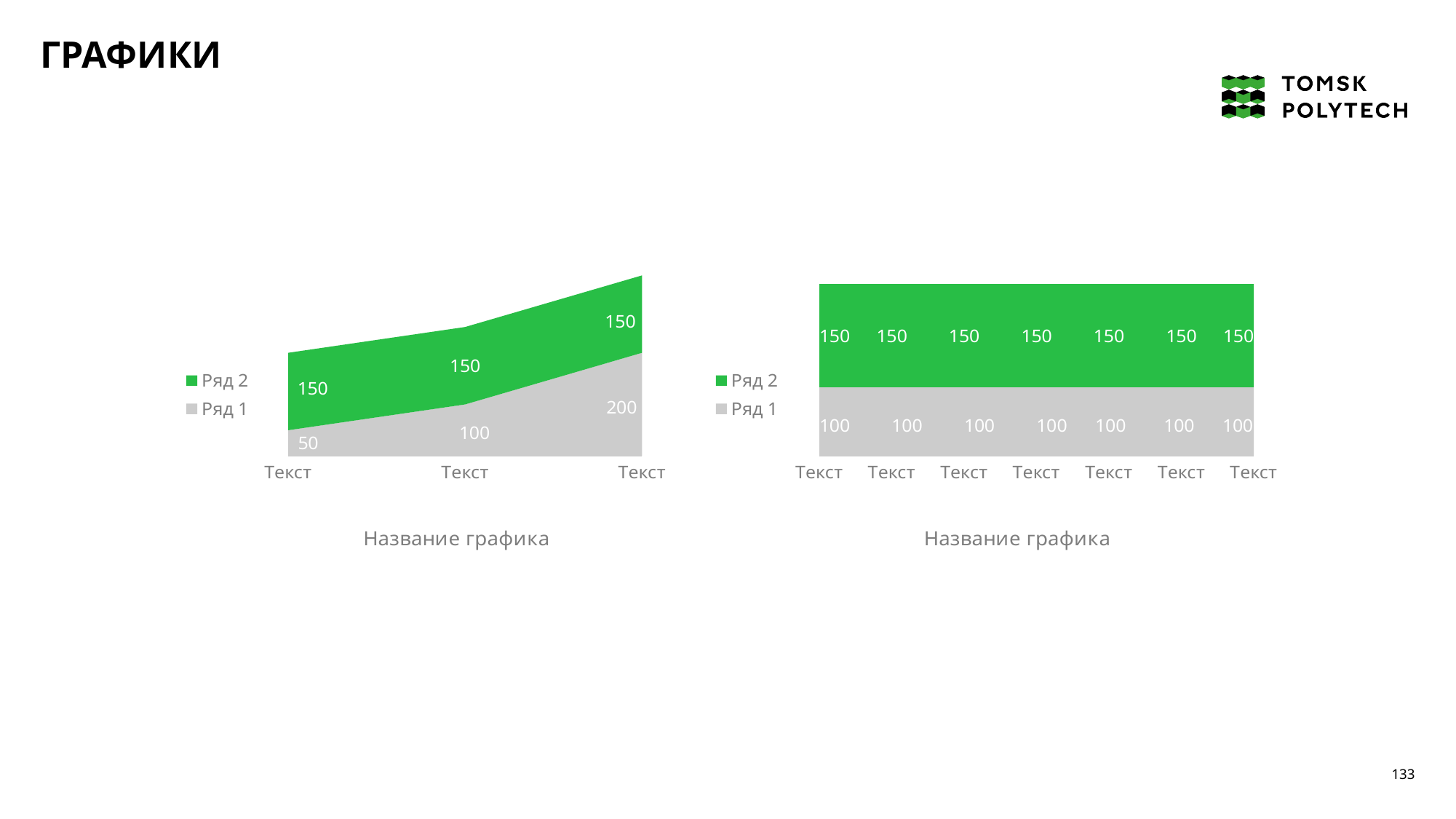
On the right chart, what is the value of Ряд 2 for each category? 150 What kind of chart is the left chart? stacked area chart On the left chart, what is the value of Ряд 1 for the first category? 50 On the left chart, how many categories are shown on the x axis? 3 On the left chart, what is the value of Ряд 2 for the second category? 150 On the left chart, what is the stacked total for the third (rightmost) category? 350 On the right chart, how many series does the legend list? 2 On the right chart, how many categories are shown on the x axis? 7 On the right chart, what is the stacked total for the first category? 250 On the left chart, what is the difference between the Ряд 1 values of the third and first categories? 150 On the left chart, what is the value of Ряд 1 for the third (rightmost) category? 200 On the left chart, do the Ряд 1 values rise or fall from left to right? rise